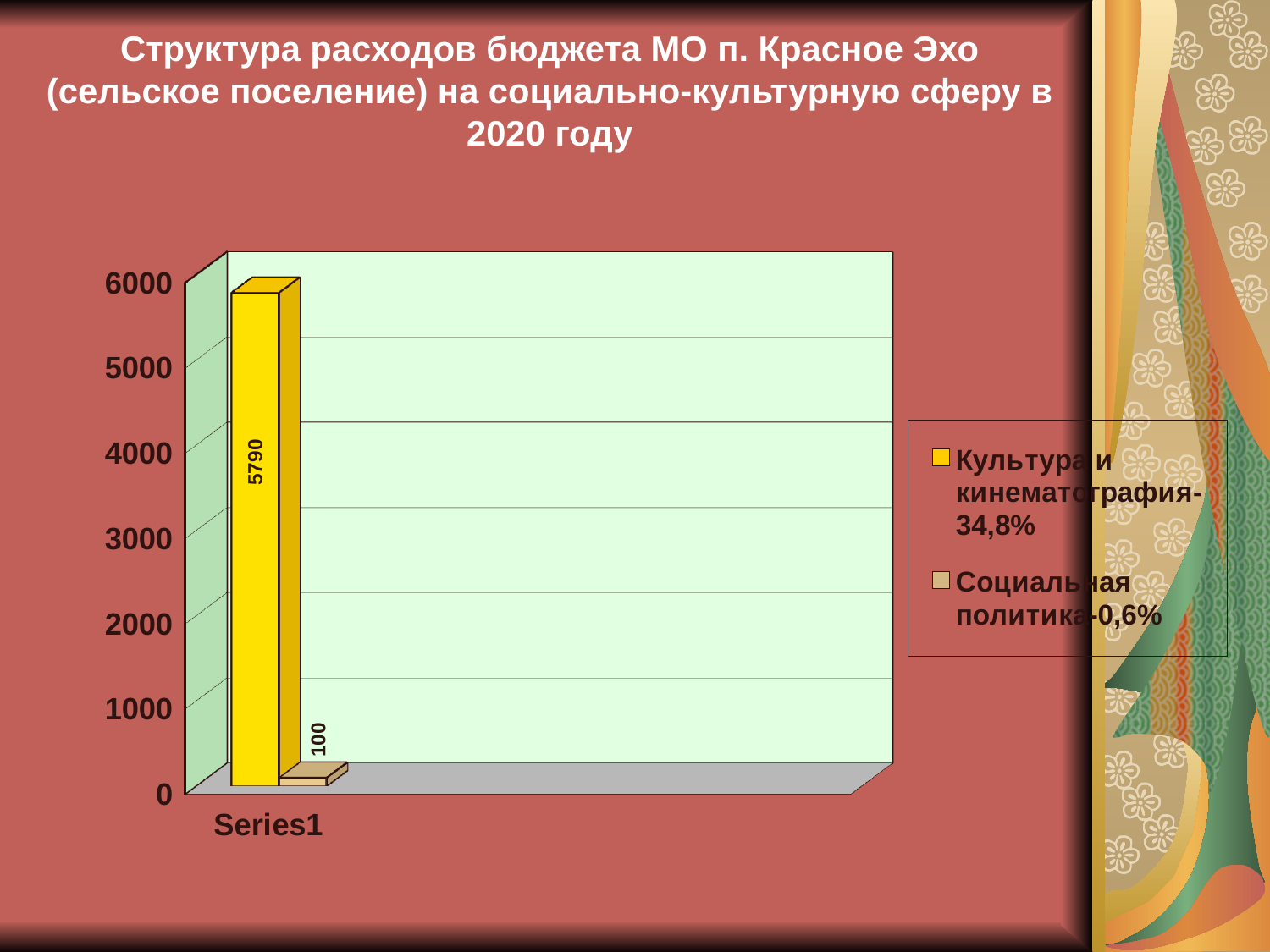
Is the value for Культура и кинематография greater or less than 5000? greater What is the value for Культура и кинематография? 5790 Which series has the lowest value? Социальная политика How many series does the legend list? 2 Which series has the highest value? Культура и кинематография What kind of chart is shown on the slide? bar chart What percentage is shown in the legend entry for Социальная политика? 0,6% What is the value for Социальная политика? 100 Which is larger, the value for Культура и кинематография or the value for Социальная политика? Культура и кинематография What colour are the bars for Культура и кинематография? yellow Is the value for Социальная политика greater or less than 1000? less What is the difference between the values for Культура и кинематография and Социальная политика? 5690